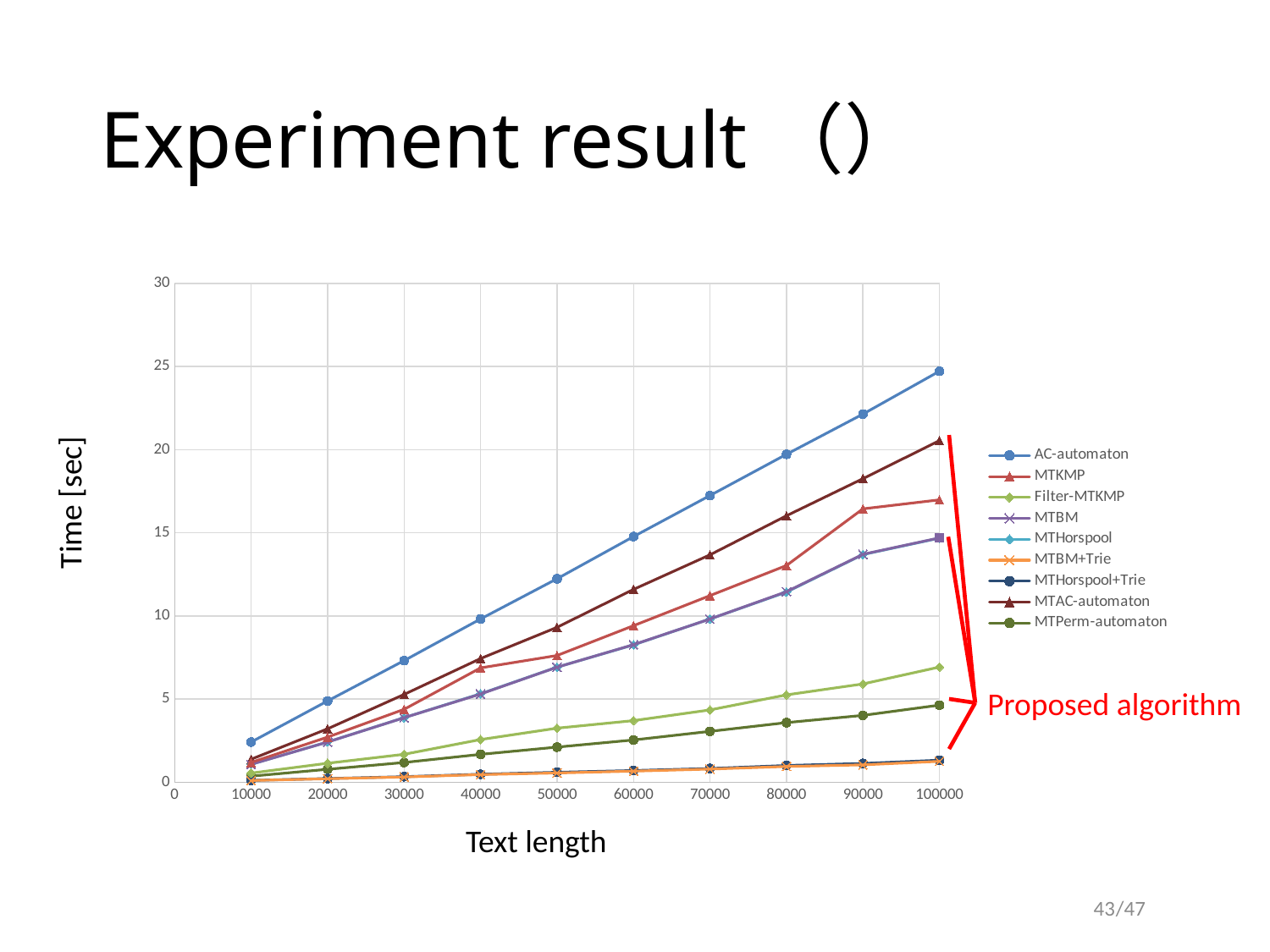
How many series does the legend list? 9 Which series has the highest time at a text length of 100000? AC-automaton At text length 100000, which is larger: AC-automaton or MTKMP? AC-automaton Is the value for AC-automaton at text length 50000 greater or less than 10? greater Is the value for MTKMP at text length 100000 greater or less than 20? less How many text-length points are plotted for each series? 10 Is the value for Filter-MTKMP at text length 100000 greater or less than 5? greater What kind of chart is shown on the slide? line chart What is the label of the vertical axis? Time [sec] At text length 100000, which is larger: MTAC-automaton or MTBM? MTAC-automaton Does the time for AC-automaton rise or fall as text length increases? rise